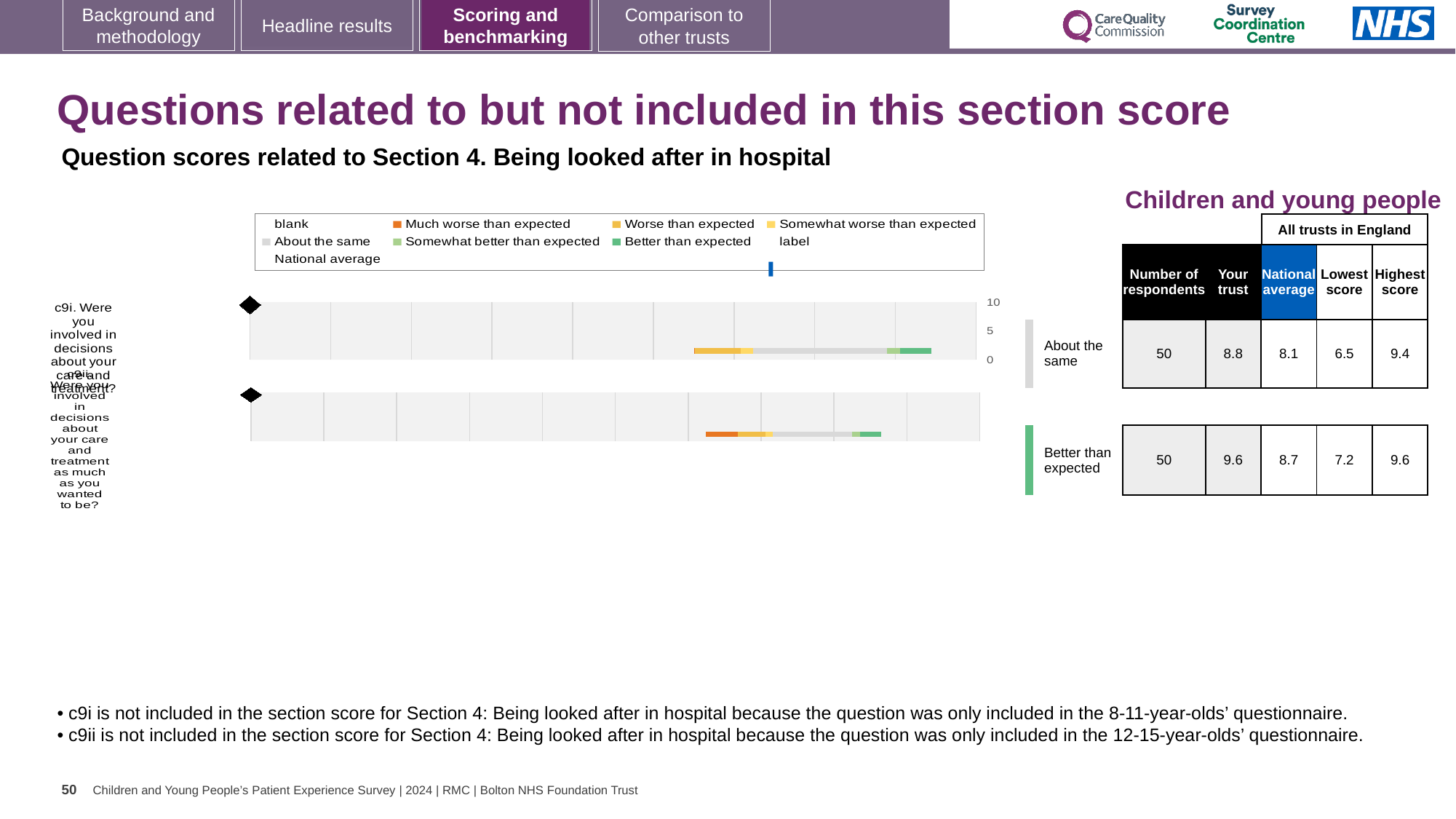
In the table next to the charts, what is the 'Your trust' score for c9ii (the 'Better than expected' row)? 9.6 What kind of chart is used to show the question scores for c9i and c9ii? bar chart How many entries does the chart legend list? 9 Which question, c9i or c9ii, is rated 'Better than expected' on the slide? c9ii What colour represents 'Better than expected' in the chart legend? green What is the highest tick value shown on the chart's score axis? 10 In the table next to the charts, which is larger for c9i: the 'Your trust' score or the national average? Your trust In the table next to the charts, what is the lowest score for c9ii (the 'Better than expected' row)? 7.2 In the table next to the charts, what is the national average for c9i (the 'About the same' row)? 8.1 How many question bars (c9i and c9ii) are plotted on the slide? 2 In the table next to the charts, what is the difference between the 'Your trust' score and the national average for c9ii (the 'Better than expected' row)? 0.9 In the table next to the charts, what is the 'Your trust' score for c9i (the 'About the same' row)? 8.8